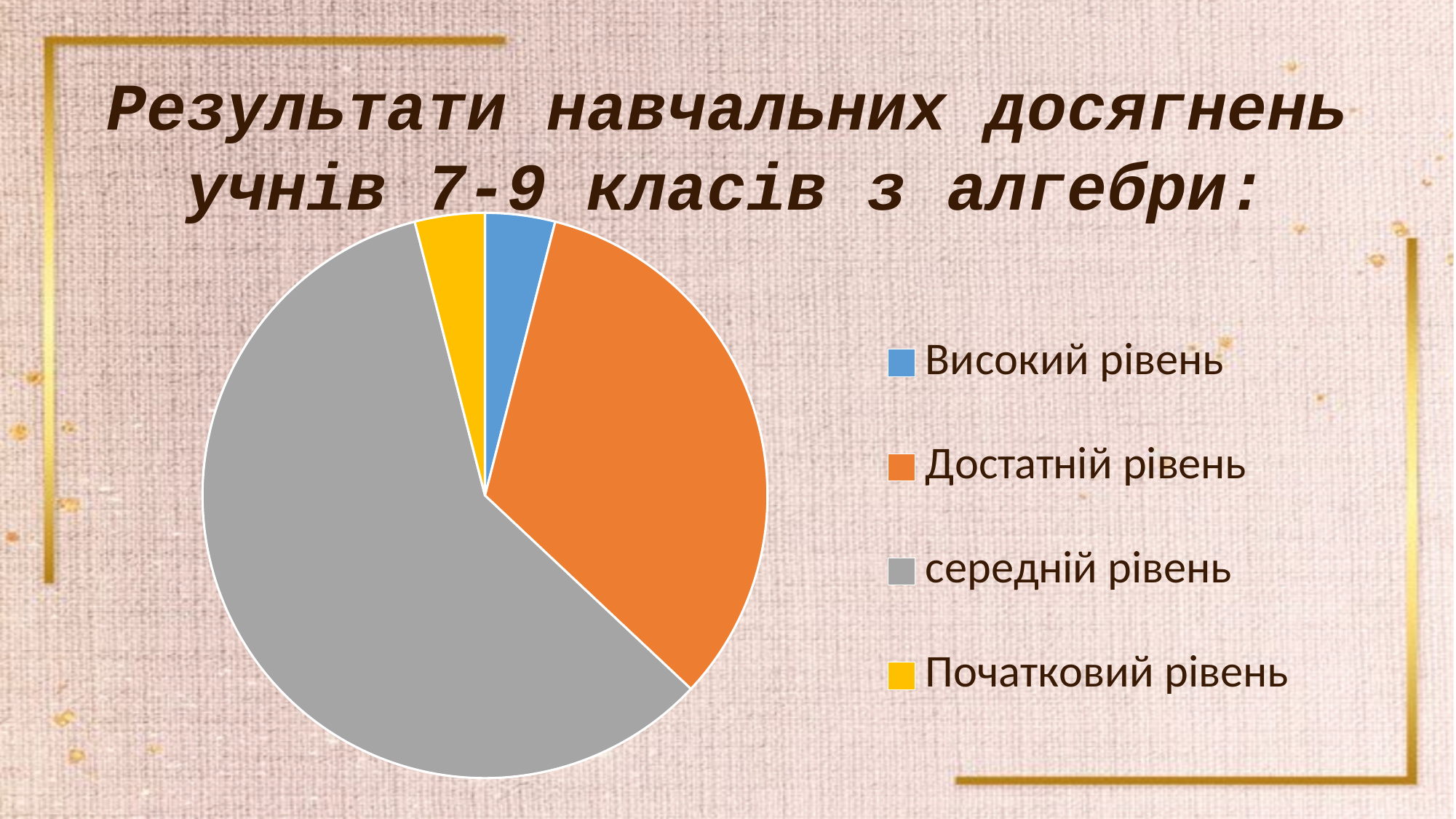
What kind of chart is shown on the slide? pie chart What is the title of the slide containing the pie chart? Результати навчальних досягнень учнів 7-9 класів з алгебри: Which category has the largest slice of the pie? середній рівень How many slices does the pie chart have? 4 Which slice is larger: Достатній рівень or Високий рівень? Достатній рівень Which slice is larger: середній рівень or Достатній рівень? середній рівень How many entries does the legend list? 4 Which category is shown in orange in the pie chart? Достатній рівень Which slice is larger: Достатній рівень or Початковий рівень? Достатній рівень